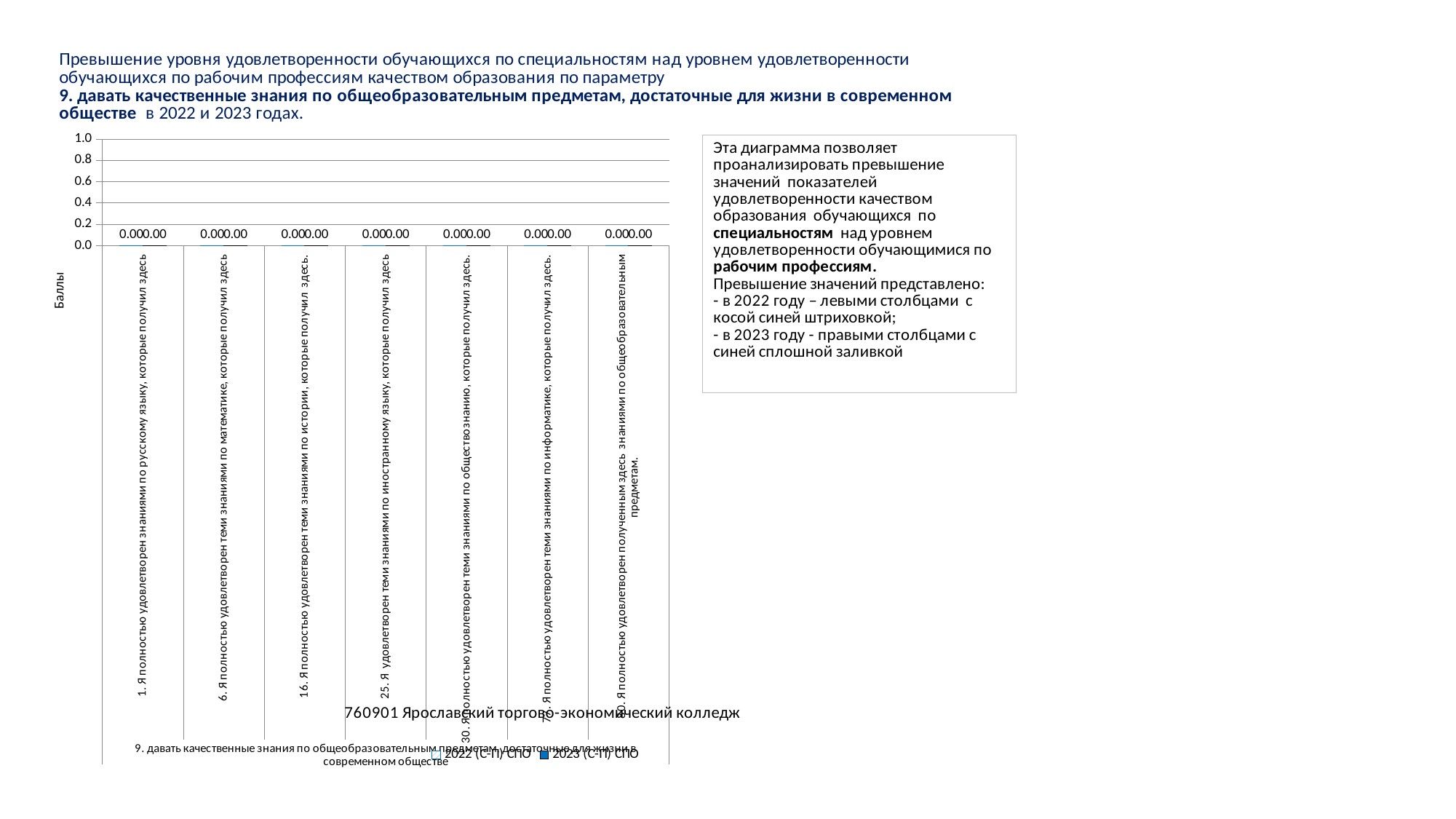
What are the two entries in the chart legend? 2022 (С-П) СПО and 2023 (С-П) СПО Is the value for the category about знания по информатике greater or less than 0.6? less What data label is printed for the category '1. Я полностью удовлетворен знаниями по русскому языку, которые получил здесь'? 0.00 Do the plotted values rise, fall, or stay the same across the categories on the x axis? stay the same How many categories are plotted along the x axis of the chart? 7 What is the label on the vertical axis of the chart? Баллы Is the value for the category '16. Я полностью удовлетворен теми знаниями по истории, которые получил здесь' greater or less than 0.2? less What data label is printed for the category '6. Я полностью удовлетворен теми знаниями по математике, которые получил здесь'? 0.00 What kind of chart is shown on the slide? bar chart Is the value for the category '25. Я удовлетворен теми знаниями по иностранному языку, которые получил здесь' greater or less than 0.4? less How many series does the chart legend list? 2